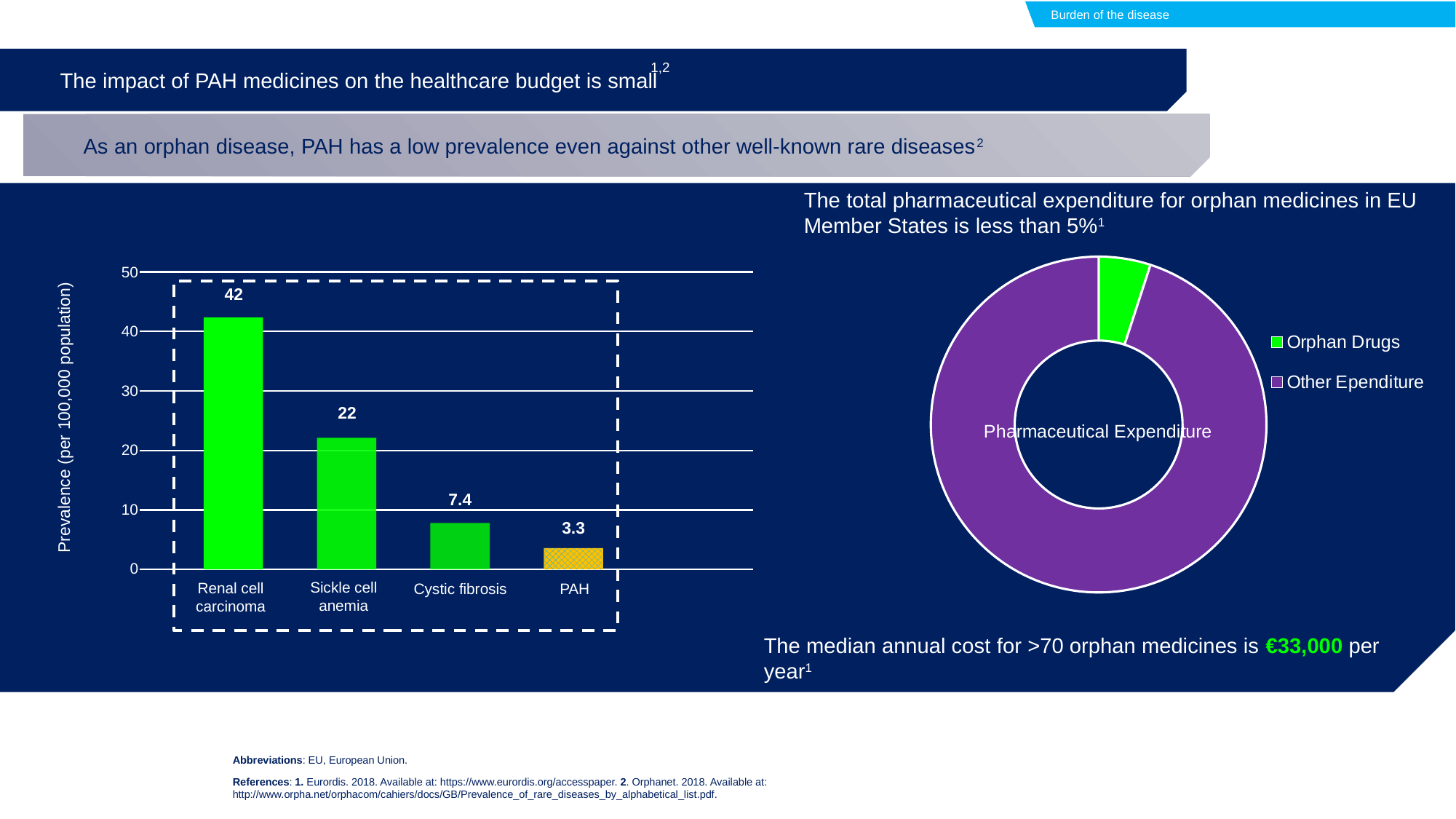
What is the y-axis label of the bar chart on the left? Prevalence (per 100,000 population) How many diseases are shown in the bar chart on the left? 4 In the bar chart on the left, what is the prevalence value for Cystic fibrosis? 7.4 In the bar chart on the left, what is the prevalence value for Renal cell carcinoma? 42 In the bar chart on the left, which disease has the highest prevalence? Renal cell carcinoma In the bar chart on the left, which disease has the lowest prevalence? PAH What type of chart is the chart on the left of the slide? Bar chart How many series does the legend of the Pharmaceutical Expenditure chart on the right list? 2 In the bar chart on the left, which has a higher prevalence, Sickle cell anemia or Cystic fibrosis? Sickle cell anemia In the bar chart on the left, what is the difference between the prevalence of Renal cell carcinoma and Sickle cell anemia? 20 In the bar chart on the left, what is the prevalence value for PAH? 3.3 In the bar chart on the left, what is the difference between the prevalence of Cystic fibrosis and PAH? 4.1